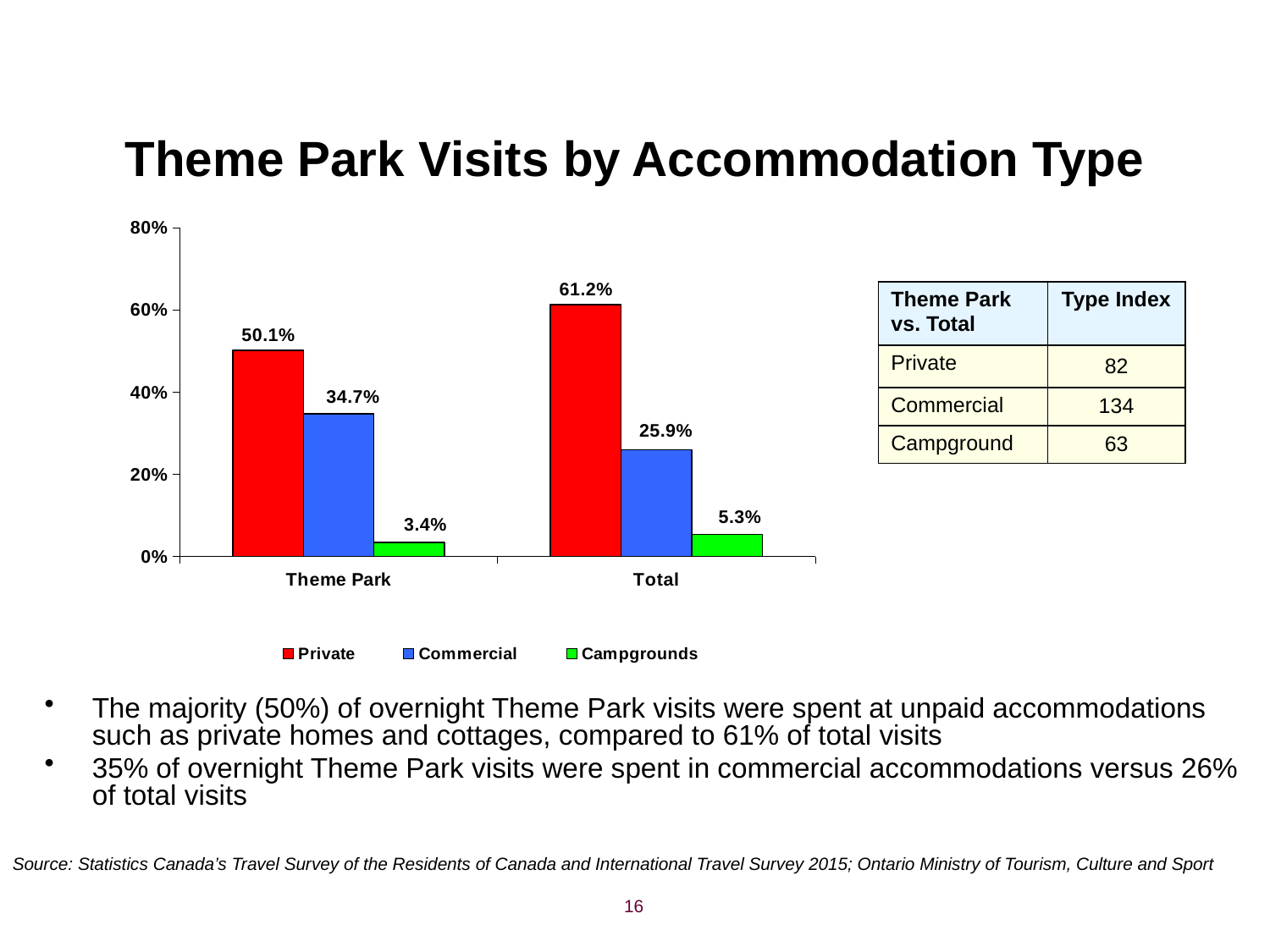
Which accommodation type has the lowest value for Theme Park? Campgrounds Which accommodation type has the highest value for Total? Private What is the Campgrounds value for Theme Park? 3.4% What colour are the Commercial bars? blue What is the Private value for Theme Park? 50.1% What is the Commercial value for Total? 25.9% How many categories are shown on the x axis? 2 How many series does the legend list? 3 What kind of chart is shown on the slide? bar chart Is the Private value for Total greater or less than 60%? greater What is the difference between the Private values for Total and Theme Park? 11.1% Which is larger, the Commercial value for Theme Park or for Total? Theme Park